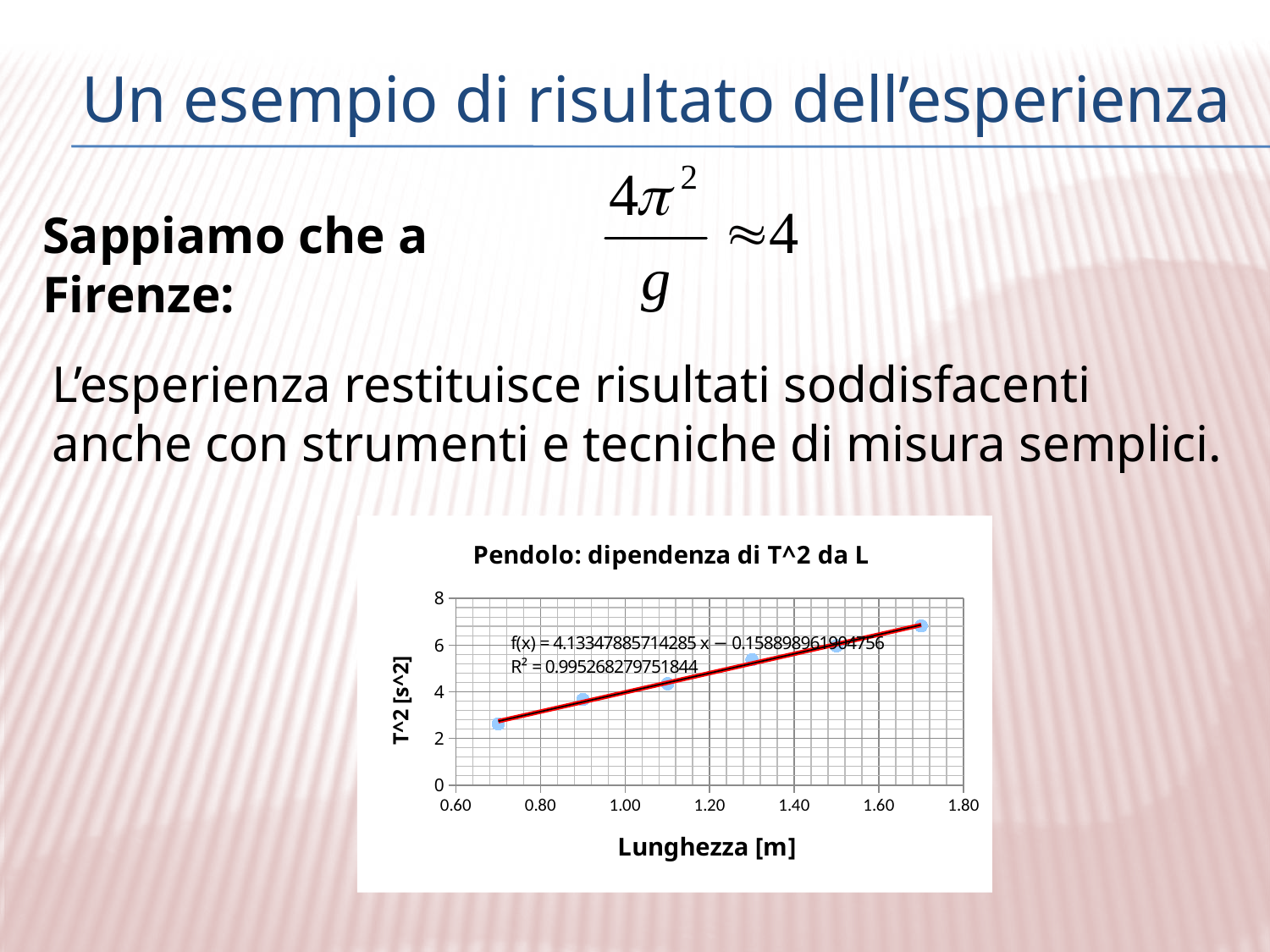
What is the label of the x axis of the chart? Lunghezza [m] At which Lunghezza value is the lowest T^2 point plotted? 0.70 Is the T^2 value for the point at Lunghezza 1.30 m greater or less than 4? greater Is the T^2 value for the point at Lunghezza 0.70 m greater or less than 4? less What kind of chart is shown on the slide? scatter chart At which Lunghezza value is the highest T^2 point plotted? 1.70 Is the T^2 value for the point at Lunghezza 1.70 m greater or less than 6? greater Do the T^2 values rise or fall as Lunghezza increases along the x axis? rise How many data points are plotted in the chart? 6 Which plotted point has the highest T^2 value, the one at Lunghezza 0.70 m or the one at 1.70 m? 1.70 m What is the title of the chart? Pendolo: dipendenza di T^2 da L